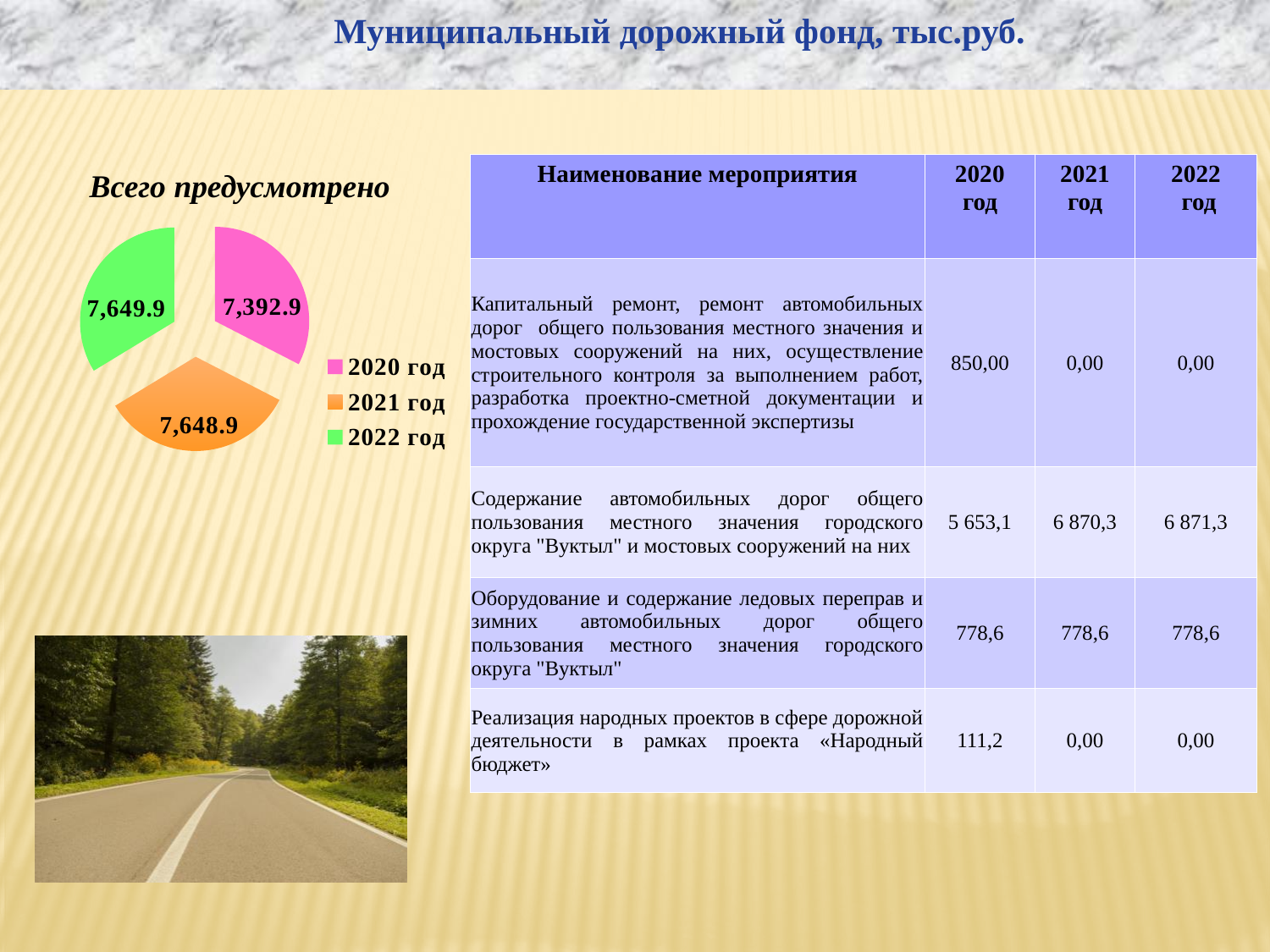
How many slices does the pie chart have? 3 What is the value for 2021 год in the pie chart? 7,648.9 Which is larger in the pie chart, the value for 2021 год or the value for 2020 год? 2021 год How many entries does the legend of the pie chart list? 3 What is the difference between the values for 2021 год and 2020 год in the pie chart? 256.0 What kind of chart is shown on the slide? pie chart What is the value for 2020 год in the pie chart? 7,392.9 What is the difference between the values for 2022 год and 2020 год in the pie chart? 257.0 What is the title of the pie chart? Всего предусмотрено Which year has the smallest slice in the pie chart? 2020 год What is the value for 2022 год in the pie chart? 7,649.9 What colour is the slice for 2021 год in the pie chart? orange